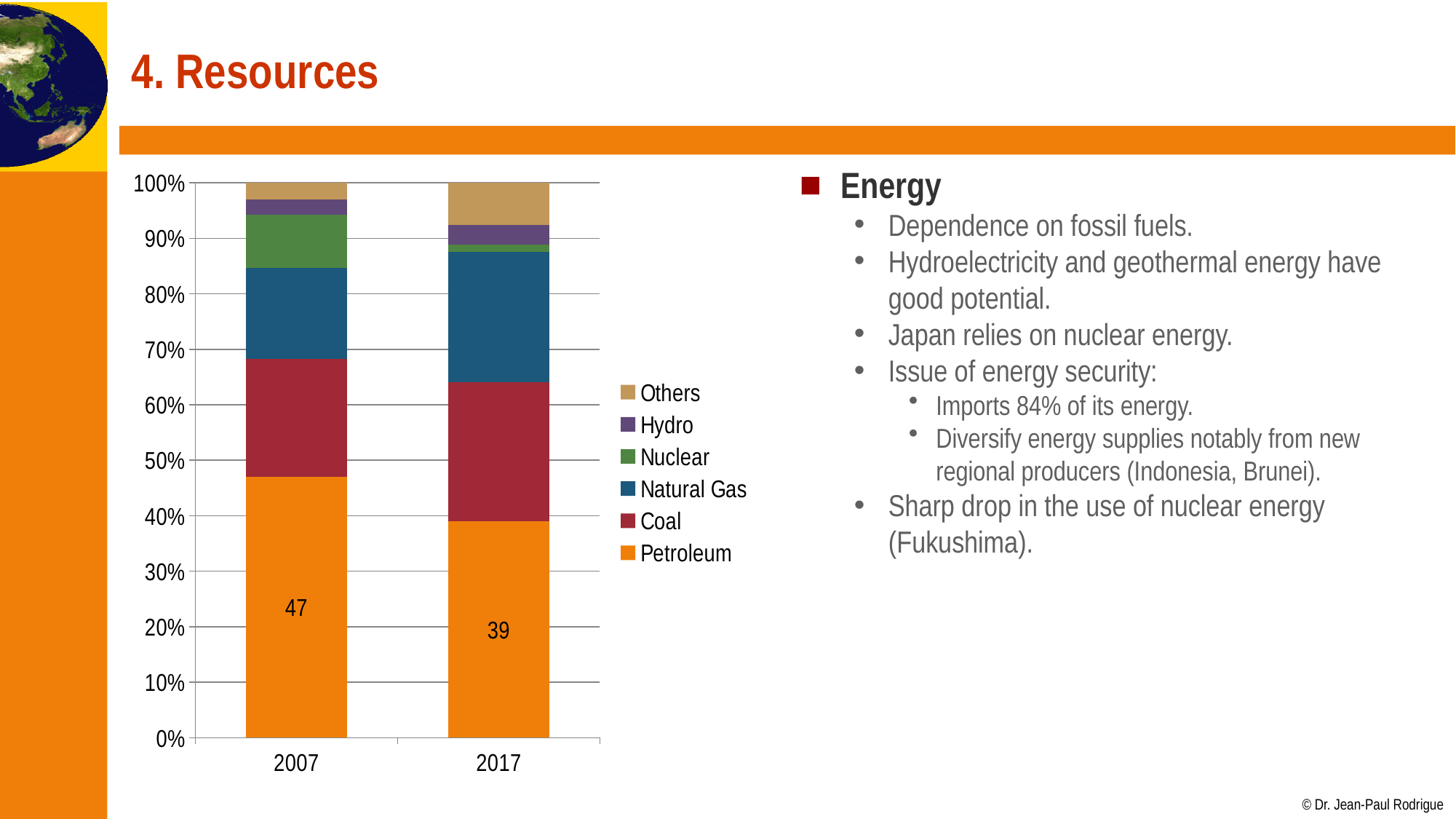
How many series does the legend list? 6 Which year has the larger Petroleum value, 2007 or 2017? 2007 Does the Petroleum share rise or fall from 2007 to 2017? fall How many years (categories) are shown on the x axis? 2 Is the Nuclear segment larger in 2007 or in 2017? 2007 What kind of chart is shown on the slide? stacked bar chart What is the difference between the Petroleum values for 2007 and 2017? 8 What is the value labelled on the Petroleum segment for 2017? 39 Is the value for Nuclear in 2017 greater or less than 10%? less Which series is listed first (at the top) in the legend? Others Is the Others segment larger in 2007 or in 2017? 2017 What is the value labelled on the Petroleum segment for 2007? 47